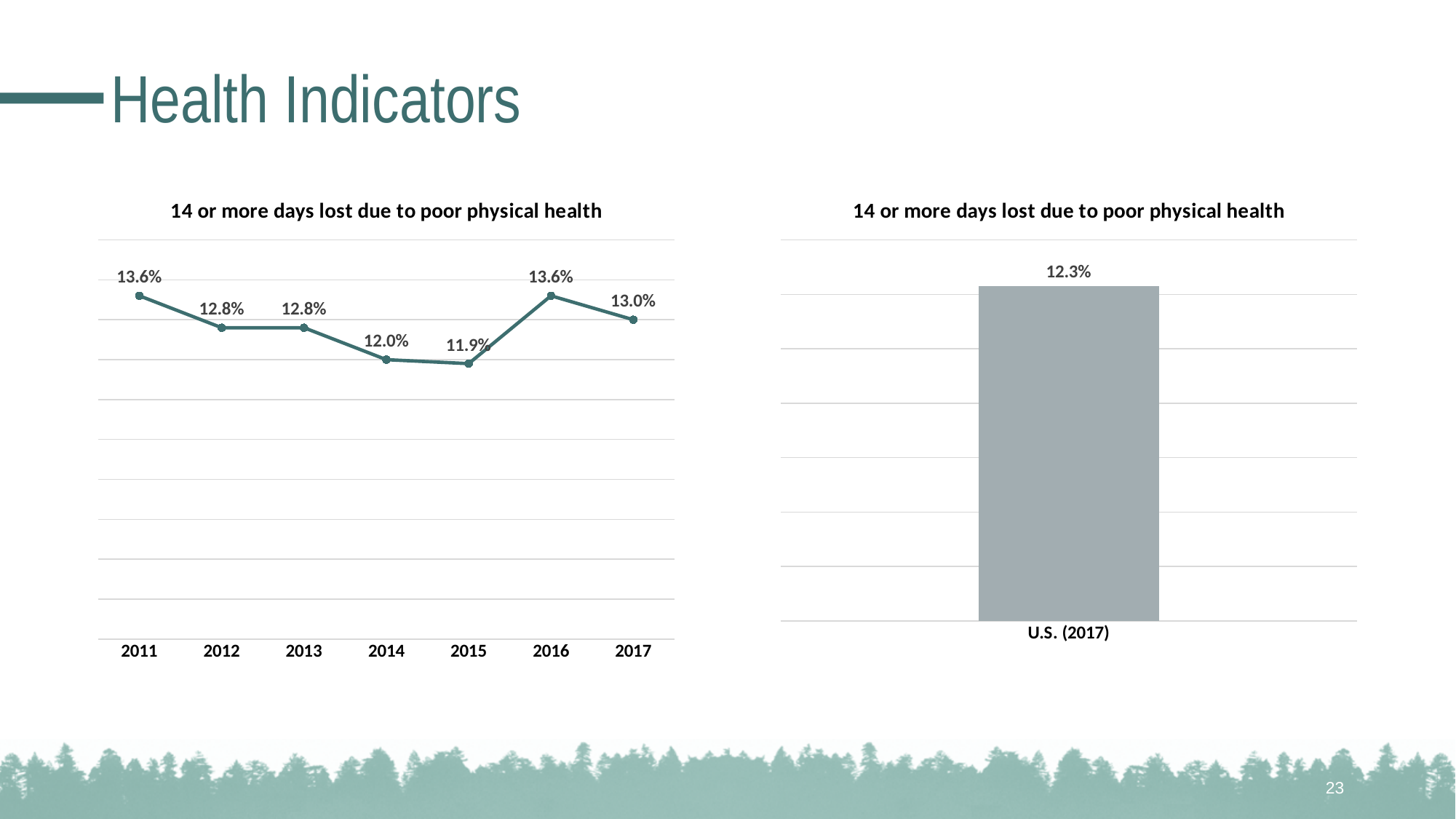
In the right chart, what is the value for U.S. (2017)? 12.3% In the left chart, which year has the lowest value? 2015 What kind of chart is the right chart? bar chart In the left chart, what is the value for 2015? 11.9% In the left chart, what is the value for 2017? 13.0% In the left chart, what is the difference between the 2016 value and the 2015 value? 1.7% In the left chart, what is the value for 2011? 13.6% How many years are plotted in the left chart? 7 What is the title of the right chart? 14 or more days lost due to poor physical health What kind of chart is the left chart? line chart In the left chart, do the values rise or fall from 2011 to 2015? fall In the left chart, which is larger, the value for 2014 or the value for 2017? 2017